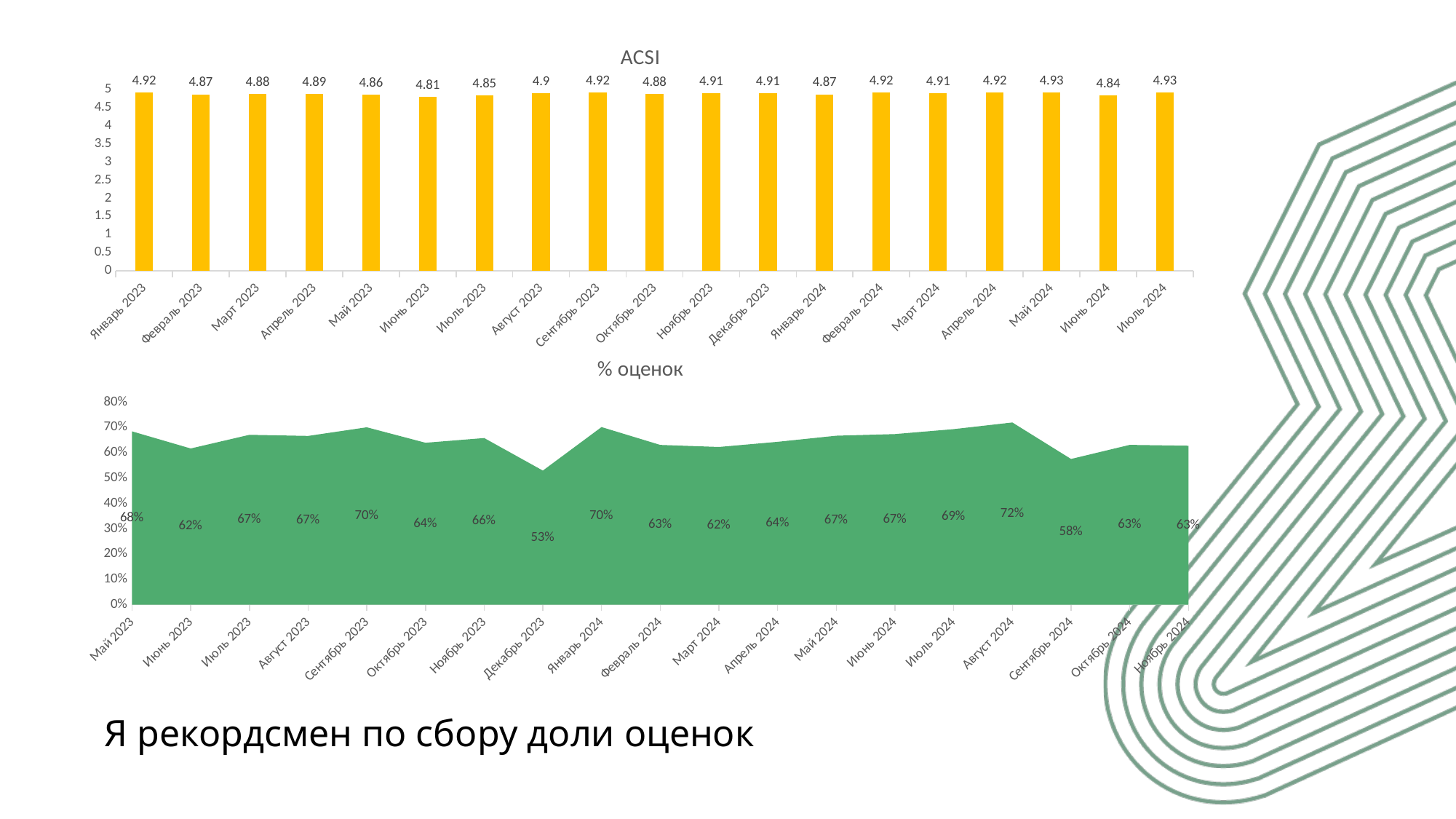
In the ACSI chart, how many months are plotted? 19 What kind of chart is the ACSI chart? Bar chart In the % оценок chart, what is the value for Сентябрь 2024? 58% In the ACSI chart, what is the difference between the values for Май 2024 and Июнь 2024? 0.09 In the % оценок chart, which month has the highest value? Август 2024 In the % оценок chart, which is larger: the value for Январь 2024 or the value for Февраль 2024? Январь 2024 In the % оценок chart, which month has the lowest value? Декабрь 2023 In the % оценок chart, what is the difference between the values for Август 2024 and Декабрь 2023? 19% What colour is the area in the % оценок chart? Green In the ACSI chart, what is the value for Август 2023? 4.9 In the ACSI chart, what is the value for Июнь 2023? 4.81 In the ACSI chart, which month has the lowest value? Июнь 2023